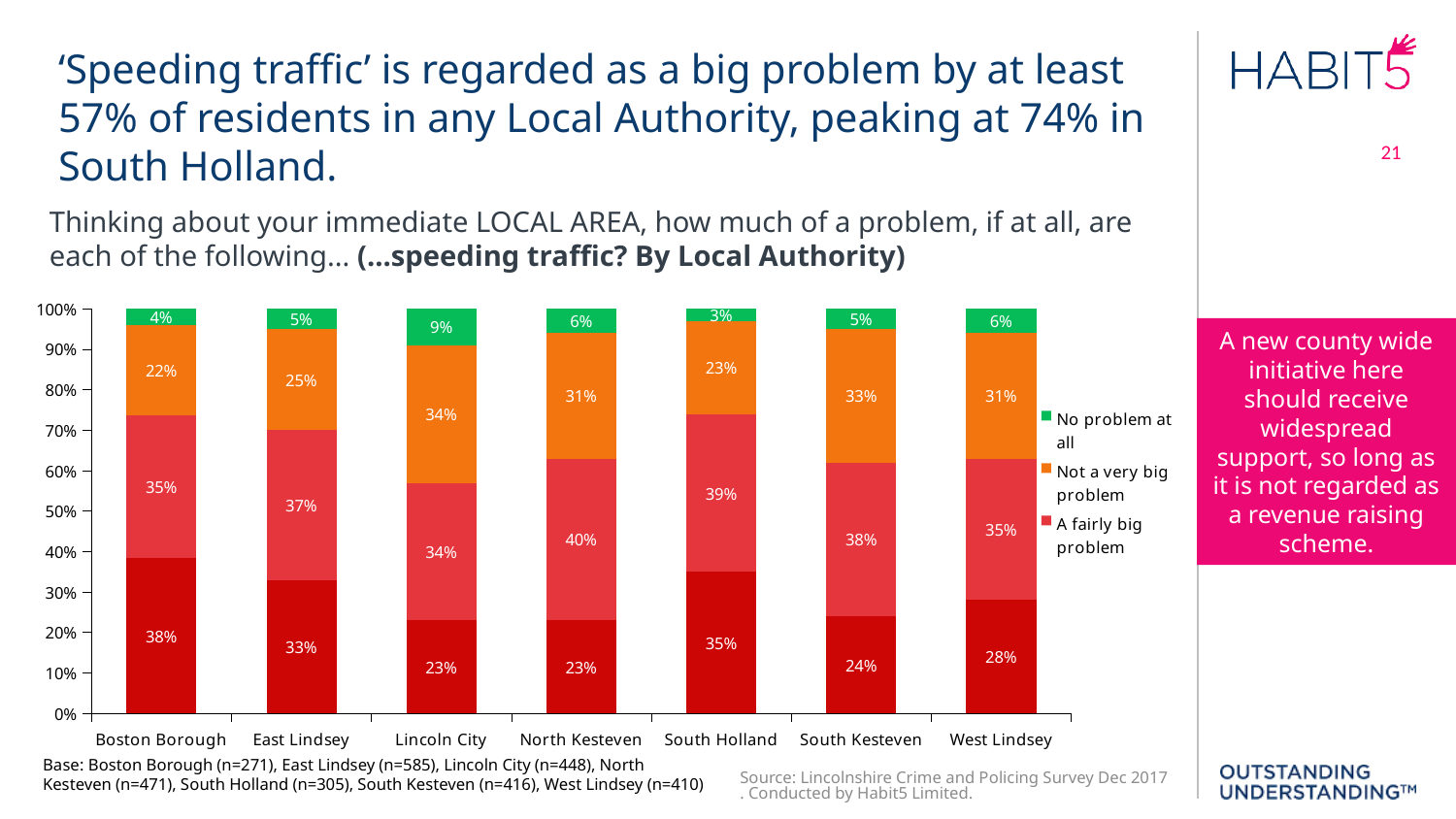
What is the 'No problem at all' value for Lincoln City? 9% Which Local Authority has the lowest 'No problem at all' percentage? South Holland What is the difference between the 'Not a very big problem' values for Lincoln City and Boston Borough? 12 percentage points What kind of chart is shown on the slide? Stacked bar chart What is the value of the bottom dark red segment for Boston Borough? 38% Which has the larger 'A fairly big problem' value, East Lindsey or West Lindsey? East Lindsey What colour represents 'No problem at all' in the chart's legend? Green What percentage of North Kesteven residents said speeding traffic is 'A fairly big problem'? 40% How many Local Authorities are shown along the x axis of the chart? 7 Which Local Authority has the highest 'No problem at all' percentage? Lincoln City How many series does the chart's legend list? 3 What is the 'Not a very big problem' value for South Kesteven? 33%